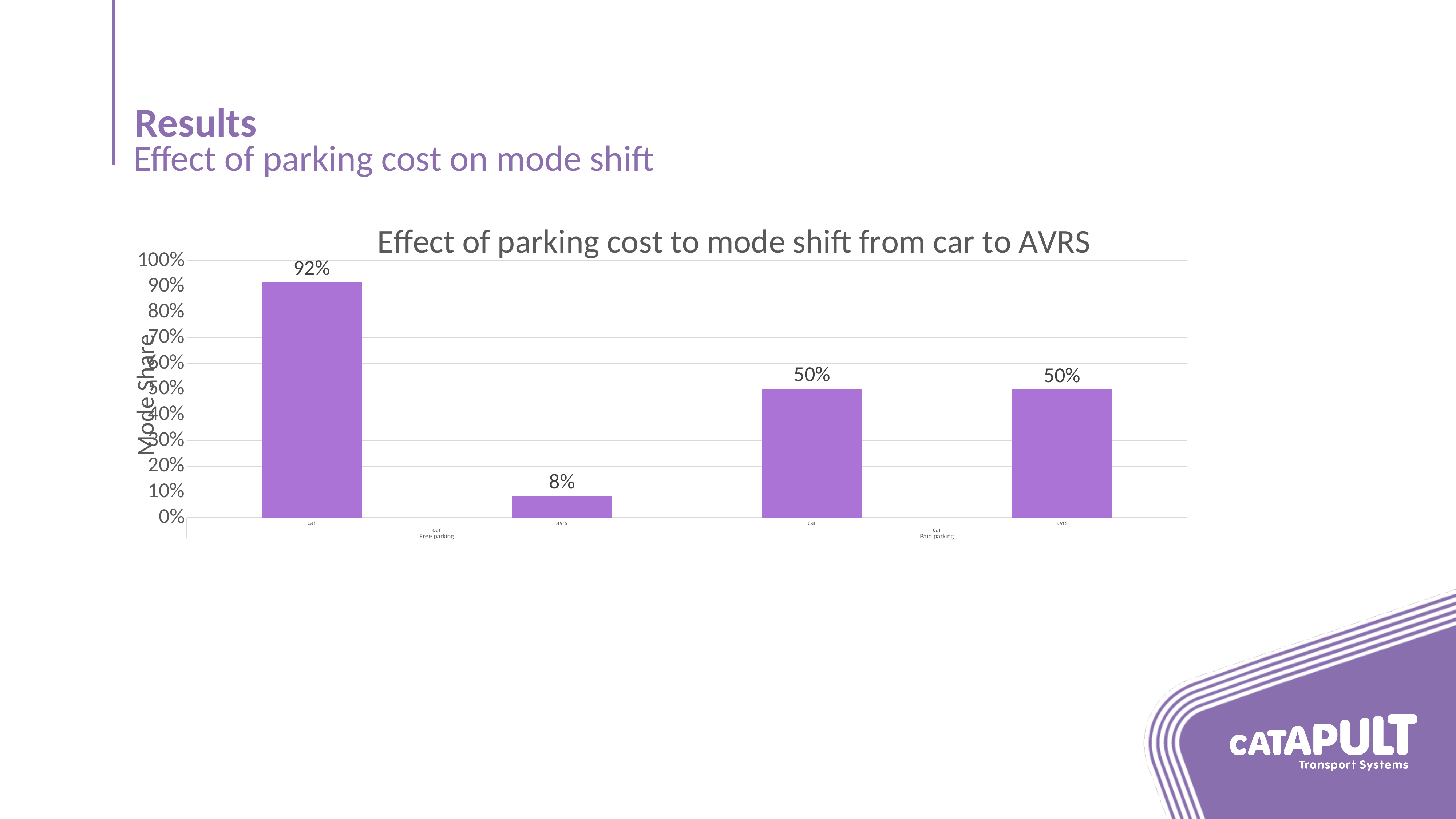
What is the mode share for avrs under Free parking? 8% Under Free parking, which is larger: the car mode share or the avrs mode share? car What is the mode share for car under Free parking? 92% Which bar has the highest mode share? car under Free parking Which bar has the lowest mode share? avrs under Free parking What is the mode share for avrs under Paid parking? 50% What is the difference between the car and avrs mode shares under Free parking? 84% What is the title of the chart? Effect of parking cost to mode shift from car to AVRS How many bars are plotted in the chart? 4 What kind of chart is shown on the slide? bar chart Is the mode share for car under Free parking greater or less than 90%? greater What is the mode share for car under Paid parking? 50%